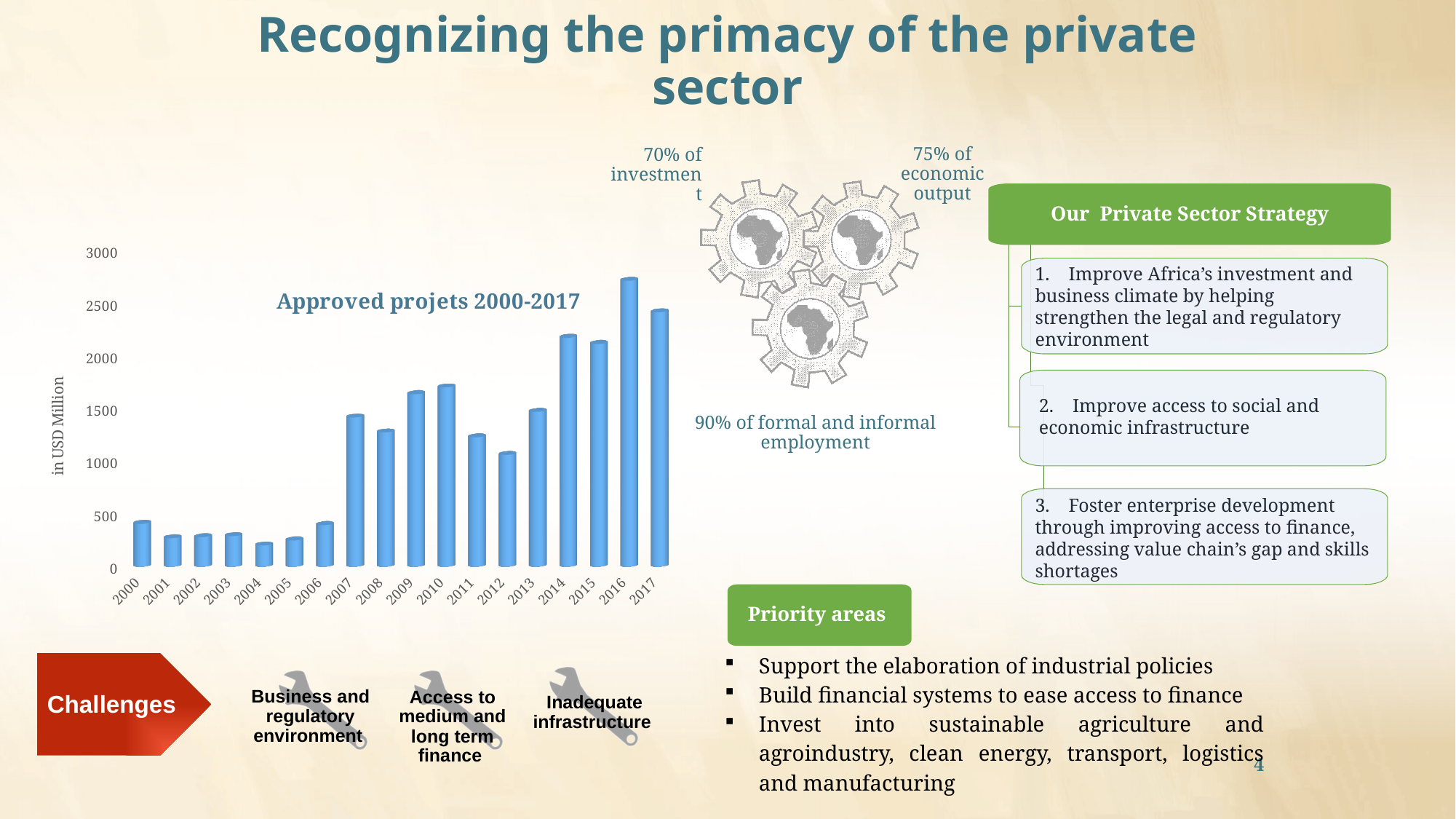
What is the label on the vertical axis of the chart? in USD Million Is the value for 2008 greater or less than 1500? less What is the title of the chart? Approved projets 2000-2017 What kind of chart is shown on the slide? bar chart Which year has the highest value of approved projects? 2016 Is the value for 2016 greater or less than 2500? greater Is the value for 2004 greater or less than 500? less How many years are plotted on the chart? 18 Overall, do the values rise or fall from 2000 to 2017? rise Which year has the larger value, 2016 or 2017? 2016